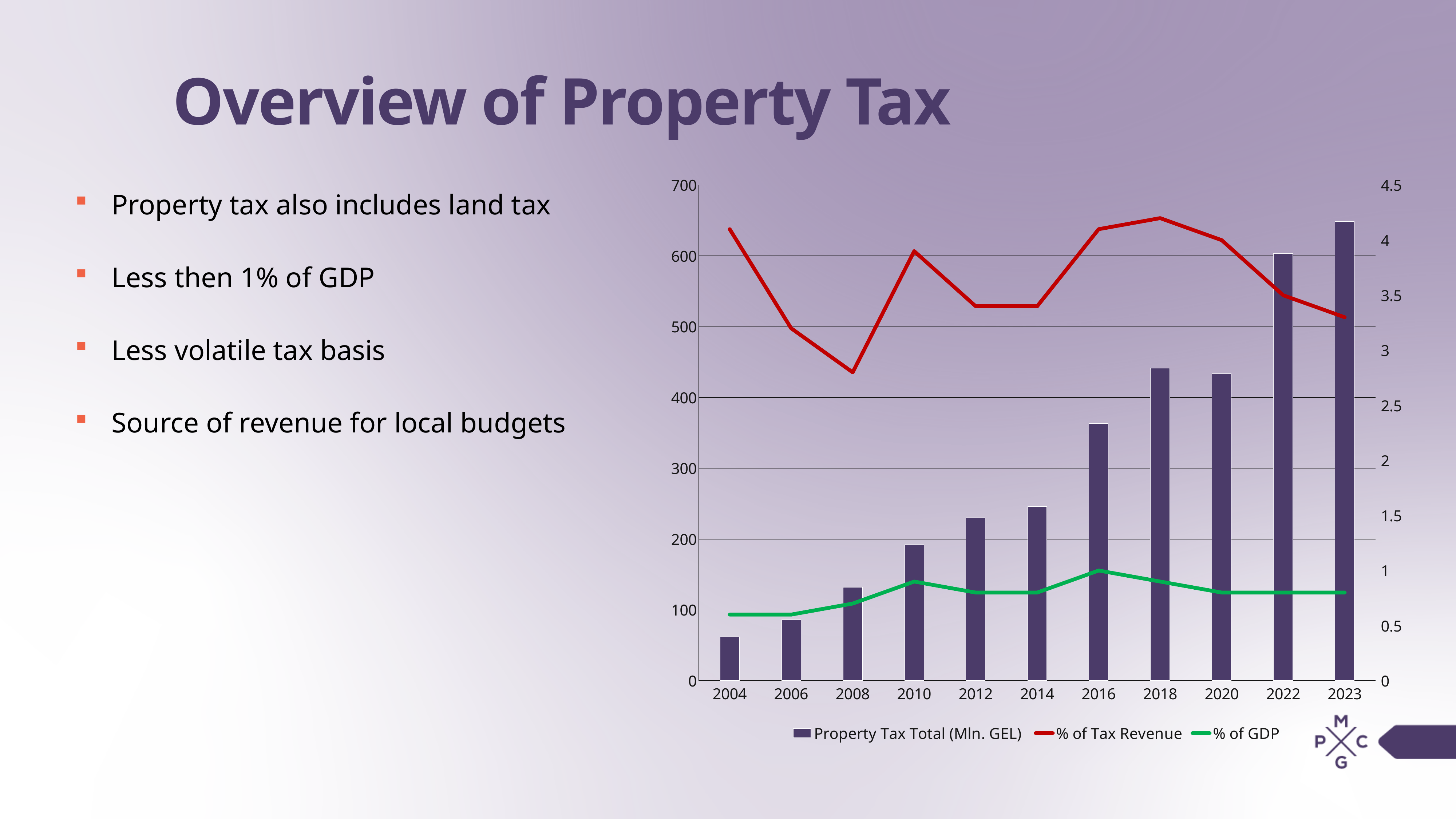
Which year has the lowest Property Tax Total (Mln. GEL) bar? 2004 Does the Property Tax Total (Mln. GEL) generally rise or fall from 2004 to 2023? rise Is the Property Tax Total (Mln. GEL) for 2016 greater or less than 400? less Which is larger, the Property Tax Total (Mln. GEL) for 2018 or for 2014? 2018 Is the Property Tax Total (Mln. GEL) for 2023 greater or less than 600? greater Is the Property Tax Total (Mln. GEL) for 2004 greater or less than 100? less Which year has the highest Property Tax Total (Mln. GEL) bar? 2023 What kind of chart is shown on the slide? A combined bar and line chart Which series is drawn with the green line? % of GDP How many years are shown on the x axis? 11 How many series does the legend list? 3